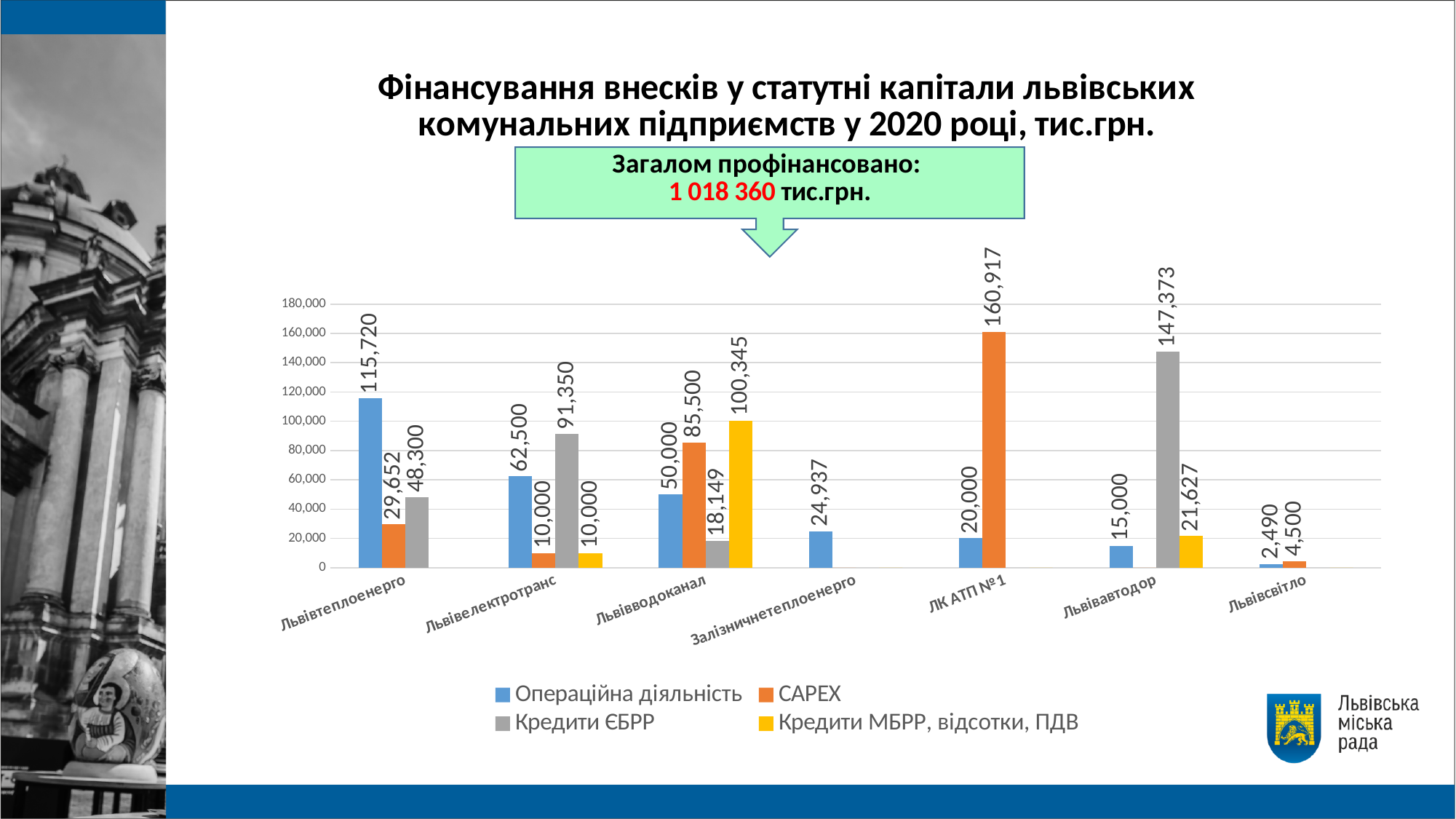
What is the value of Кредити ЄБРР for Львівавтодор? 147,373 Which category has the highest Операційна діяльність value? Львівтеплоенерго What kind of chart is shown on the slide? Bar chart How many series does the legend list? 4 What is the value of Кредити МБРР, відсотки, ПДВ for Львівводоканал? 100,345 What is the difference between the CAPEX value for Львівводоканал and the CAPEX value for Львівтеплоенерго? 55,848 What is the CAPEX value for ЛК АТП №1? 160,917 Which category has the lowest Операційна діяльність value? Львівсвітло How many categories are shown on the x axis? 7 What total amount is stated in the green box above the chart? 1 018 360 тис.грн. Which is larger: Кредити ЄБРР for Львівелектротранс or Кредити ЄБРР for Львівтеплоенерго? Львівелектротранс What is the value of Операційна діяльність for Львівтеплоенерго? 115,720